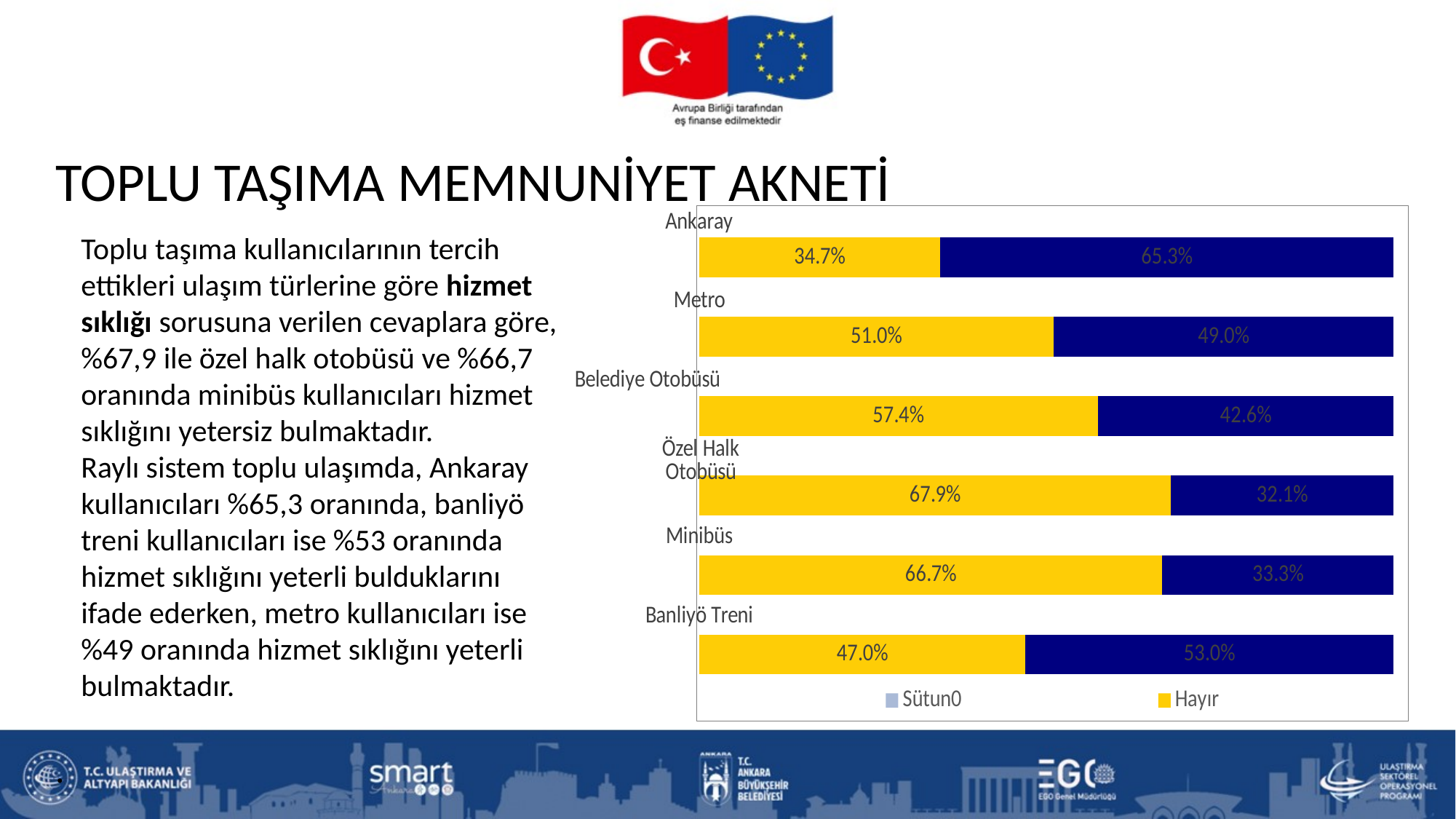
How many series does the legend list? 2 What is the total of the two segments in the Ankaray bar? 100.0% What is the value of the dark blue segment for Metro? 49.0% What kind of chart is shown on the slide? Stacked bar chart What is the Hayır (yellow) value for Ankaray? 34.7% How many categories are shown in the chart? 6 Which category has the highest Hayır (yellow) value? Özel Halk Otobüsü What is the value of the dark blue segment for Belediye Otobüsü? 42.6% Which has the larger Hayır value, Metro or Banliyö Treni? Metro What is the difference between the Hayır values for Minibüs and Banliyö Treni? 19.7 percentage points What are the two entries listed in the chart legend? Sütun0 and Hayır Which category has the lowest Hayır (yellow) value? Ankaray